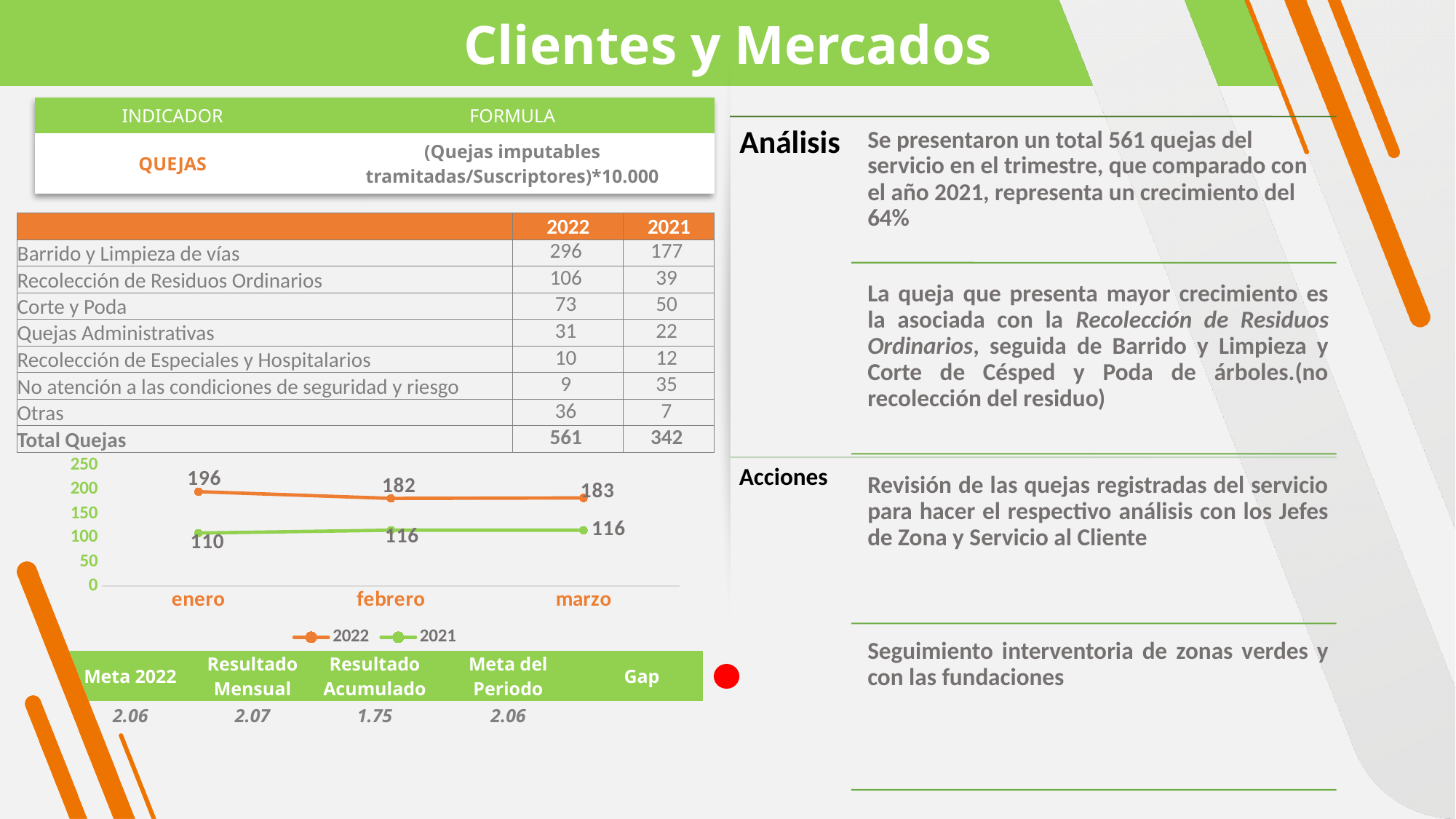
What is the value for 2021 in marzo on the line chart? 116 How many series does the legend of the line chart list? 2 Does the 2021 series rise or fall from enero to febrero on the line chart? rise Which series has the larger value in febrero on the line chart, 2022 or 2021? 2022 What is the value for 2021 in enero on the line chart? 110 In which month is the 2022 series highest on the line chart? enero What is the value for 2022 in enero on the line chart? 196 What is the value for 2022 in febrero on the line chart? 182 How many months are shown on the x axis of the line chart? 3 What kind of chart is shown on the slide? line chart In which month is the 2021 series lowest on the line chart? enero What is the difference between the 2022 and 2021 values in marzo on the line chart? 67